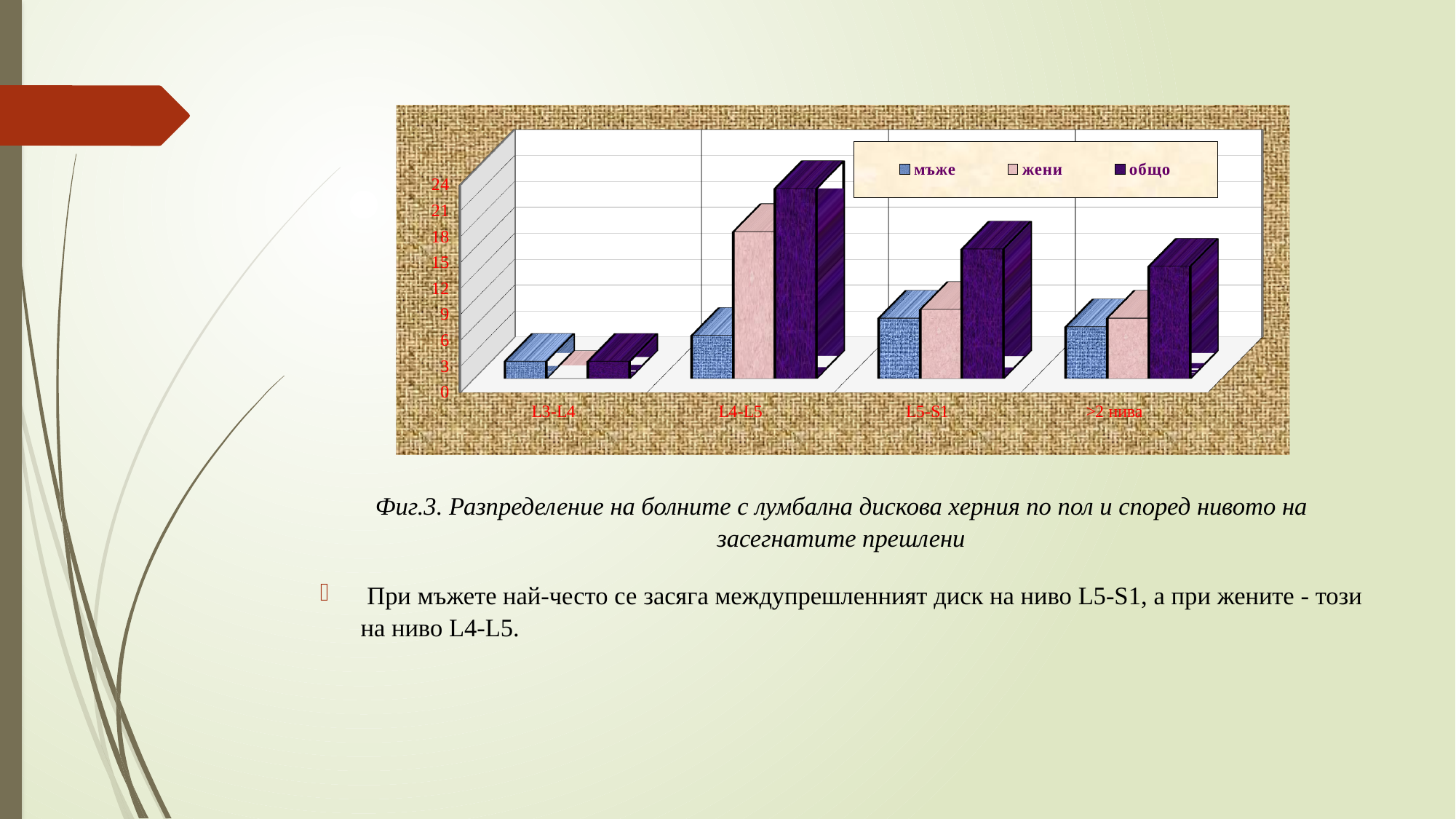
How many series does the chart's legend list? 3 For which category is the жени bar the highest? L4-L5 Is the общо value for L3-L4 greater or less than 6? less For which category is the общо bar the lowest? L3-L4 Is the общо value for L4-L5 greater or less than 18? greater For which category is the общо bar the highest? L4-L5 Is the жени value for L4-L5 greater or less than 12? greater For which category is the мъже bar the highest? L5-S1 For the L4-L5 category, which is larger: the мъже bar or the жени bar? жени What kind of chart is shown on the slide? bar chart Which series are listed in the chart's legend? мъже, жени, общо How many categories are shown on the x axis of the chart? 4